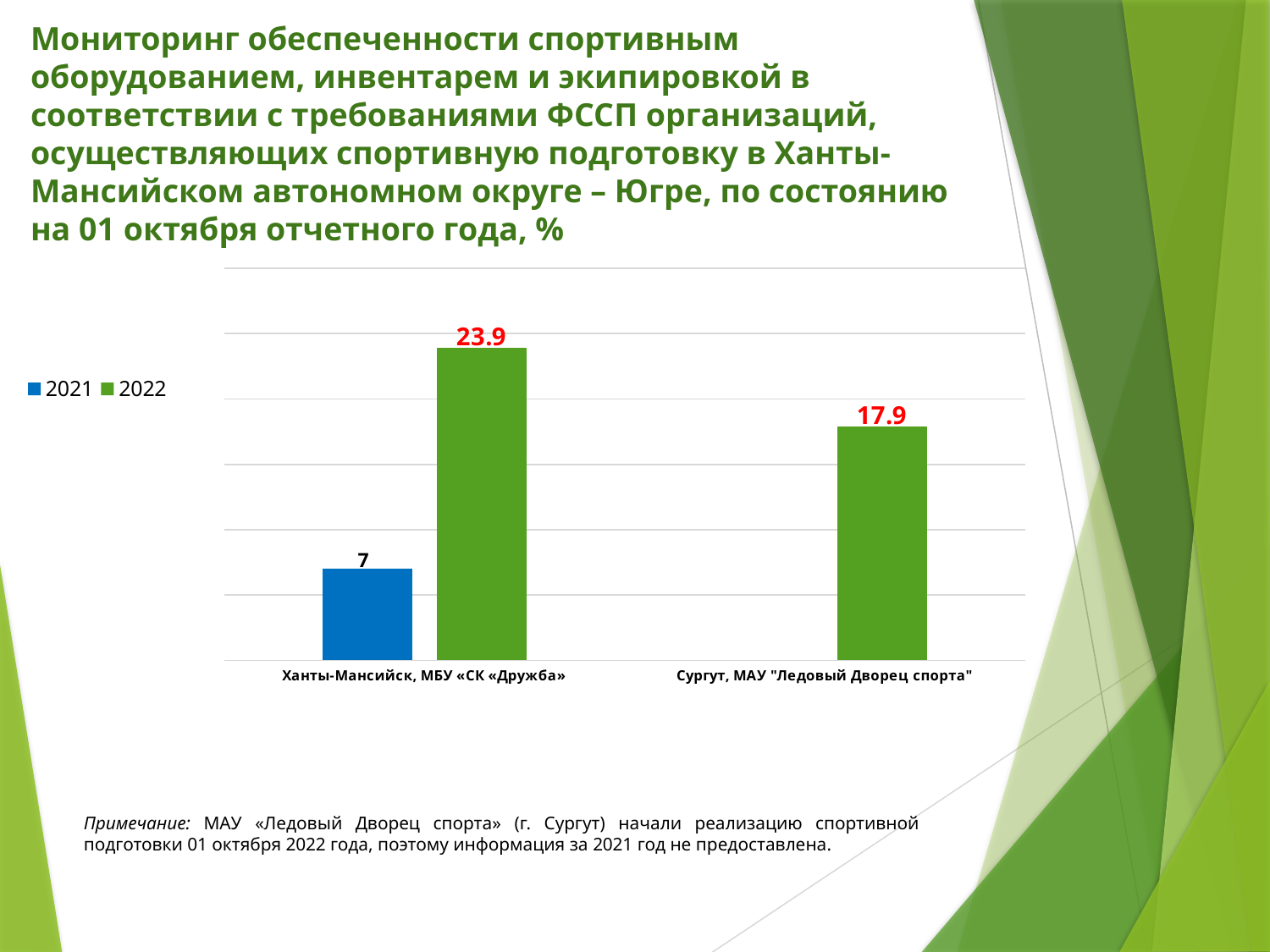
What is the difference between the 2022 and 2021 values for Ханты-Мансийск, МБУ «СК «Дружба»? 16.9 Which category has the lowest 2022 value? Сургут, МАУ "Ледовый Дворец спорта" What is the 2022 value for Ханты-Мансийск, МБУ «СК «Дружба»? 23.9 What is the difference between the 2022 values for Ханты-Мансийск, МБУ «СК «Дружба» and Сургут, МАУ "Ледовый Дворец спорта"? 6 Which is larger for Ханты-Мансийск, МБУ «СК «Дружба»: the 2021 value or the 2022 value? 2022 What is the 2021 value for Ханты-Мансийск, МБУ «СК «Дружба»? 7 What is the 2022 value for Сургут, МАУ "Ледовый Дворец спорта"? 17.9 What are the series listed in the legend? 2021 and 2022 What type of chart is shown on the slide? bar chart Which category has the highest 2022 value? Ханты-Мансийск, МБУ «СК «Дружба» How many series does the legend list? 2 How many categories are shown on the x axis? 2